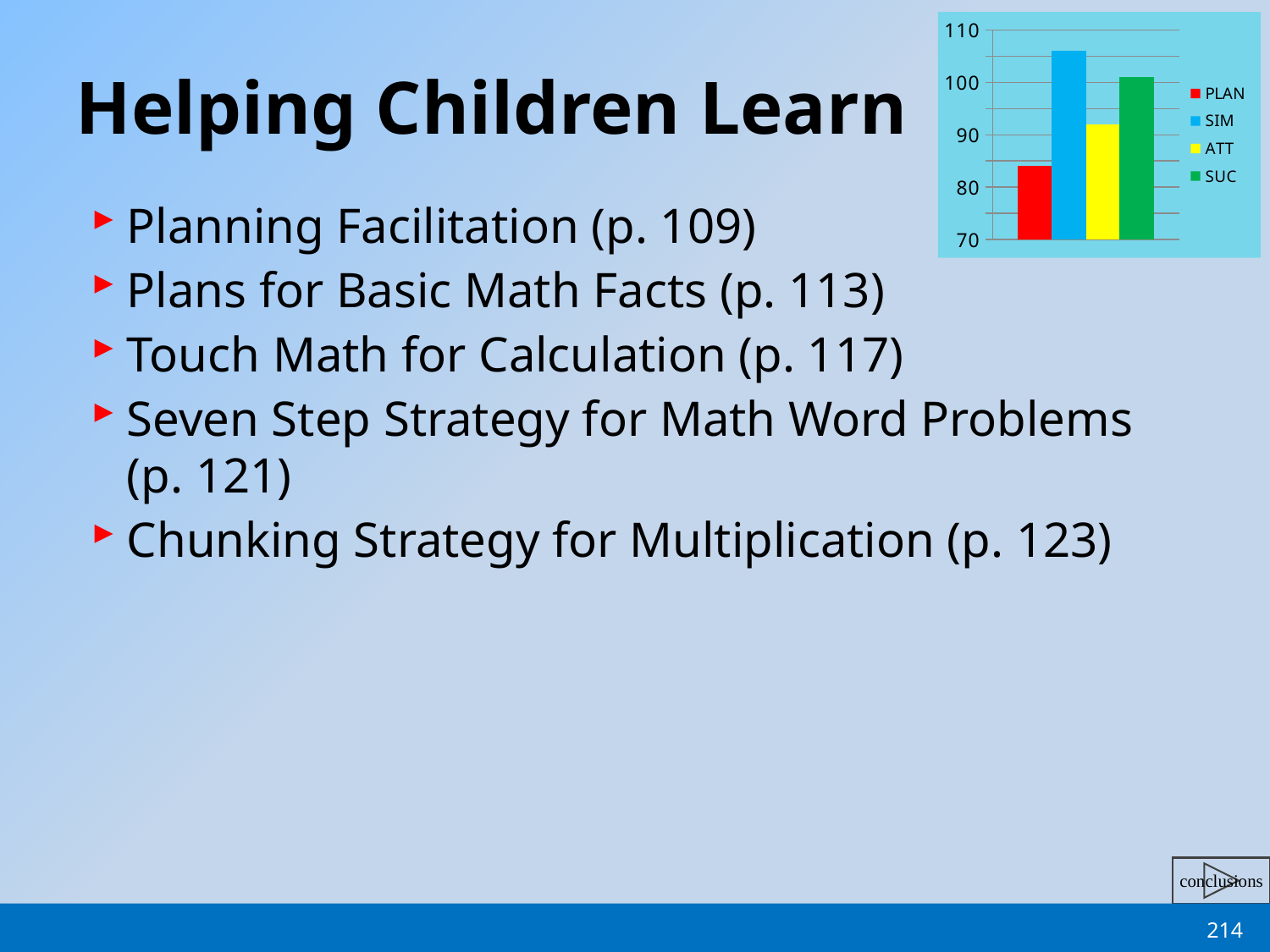
Is the value for PLAN greater or less than 90? less What are the four legend entries of the chart, in order? PLAN, SIM, ATT, SUC Is the value for SUC greater or less than 90? greater Which series has the highest bar in the chart? SIM Which series has the lowest bar in the chart? PLAN How many series does the chart's legend list? 4 Which is larger, the value for PLAN or the value for SUC? SUC What kind of chart is shown on the slide? bar chart Is the value for ATT greater or less than 100? less What colour is the bar for the PLAN series? red Which is larger, the value for SIM or the value for ATT? SIM